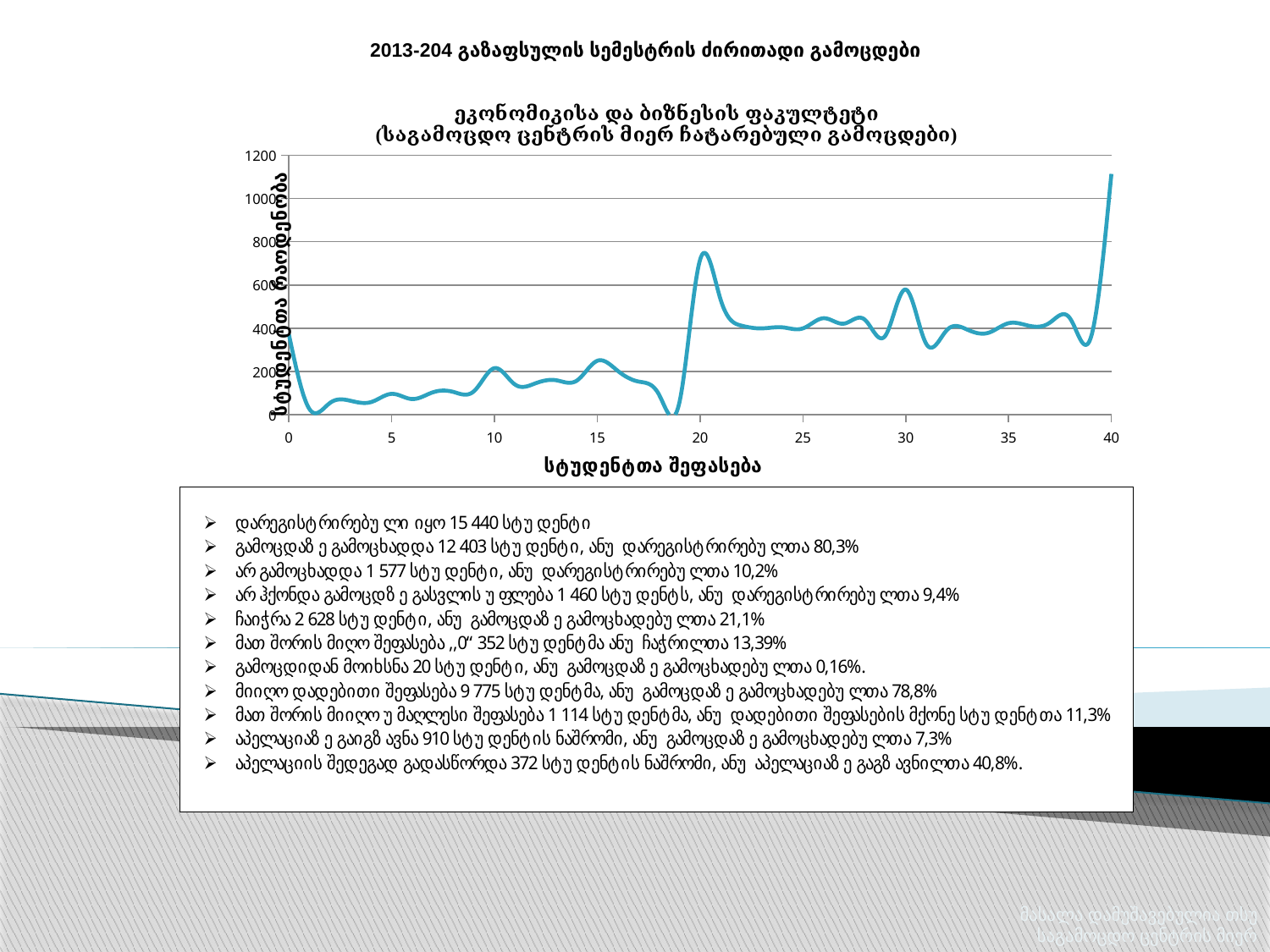
Is the value at a score of 5 greater or less than 200? less What is the label of the x axis of the chart? სტუდენტთა შეფასება At which score on the x axis does the line reach its highest value? 40 Is the value at a score of 25 greater or less than 600? less Is the value at a score of 40 greater or less than 1000? greater What kind of chart is shown on the slide? line chart What is the label of the y axis of the chart? სტუდენტთა რაოდენობა What is the highest value shown on the y axis? 1200 Which is larger, the value at a score of 20 or the value at a score of 10? the value at a score of 20